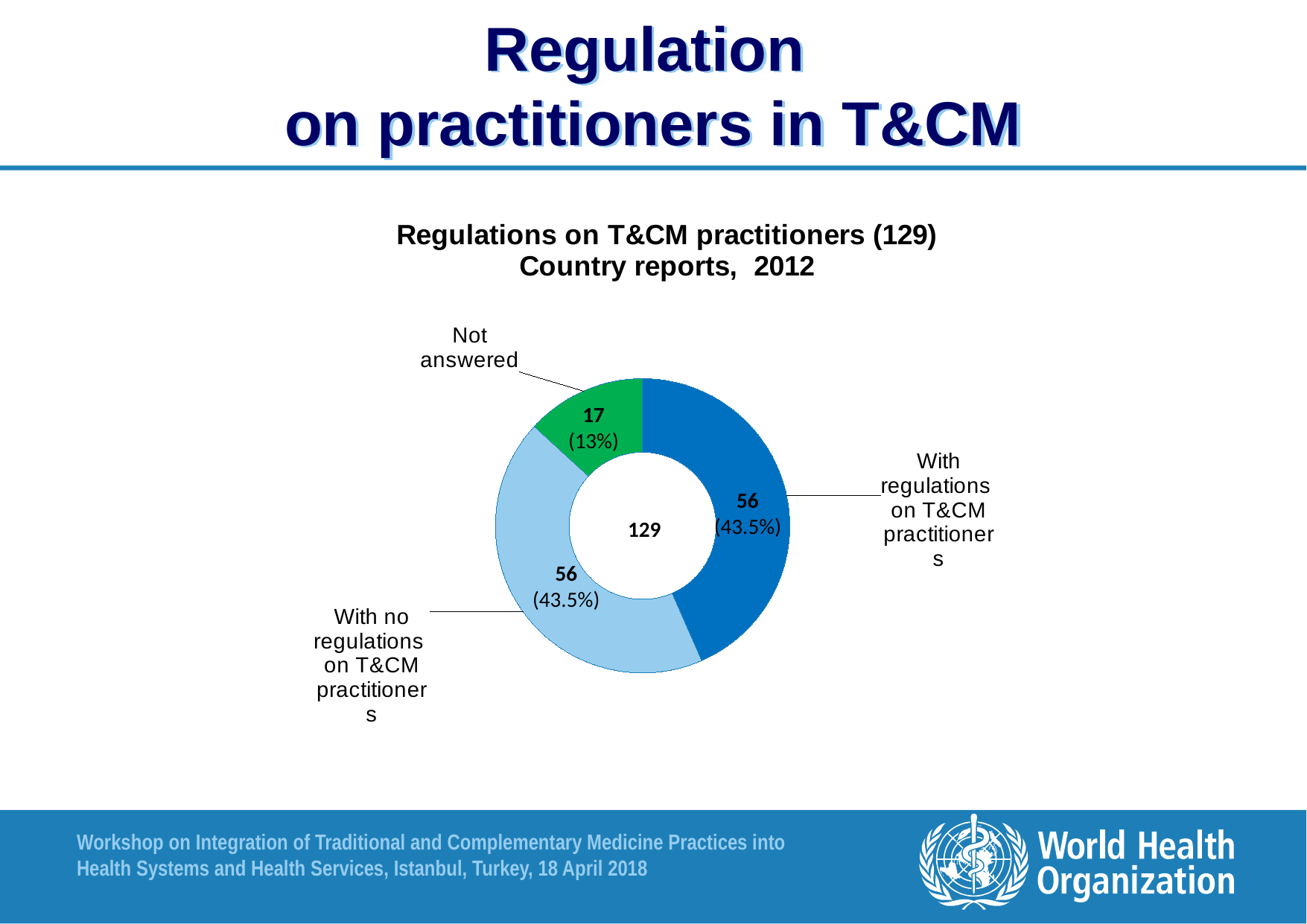
How many categories does the chart show? 3 Is the number of countries with no regulations on T&CM practitioners greater or less than the number that did not answer? greater What percentage of countries did not answer? 13% What is the title of the chart? Regulations on T&CM practitioners (129) Country reports, 2012 How many countries reported having no regulations on T&CM practitioners? 56 How many countries did not answer the question on regulations on T&CM practitioners? 17 What is the difference between the number of countries with regulations and the number that did not answer? 39 How many countries reported having regulations on T&CM practitioners? 56 What share of countries reported having regulations on T&CM practitioners? 43.5% What is the total number of country reports shown in the centre of the chart? 129 Which category has the smallest slice in the chart? Not answered What type of chart is shown on the slide? Pie chart (doughnut)